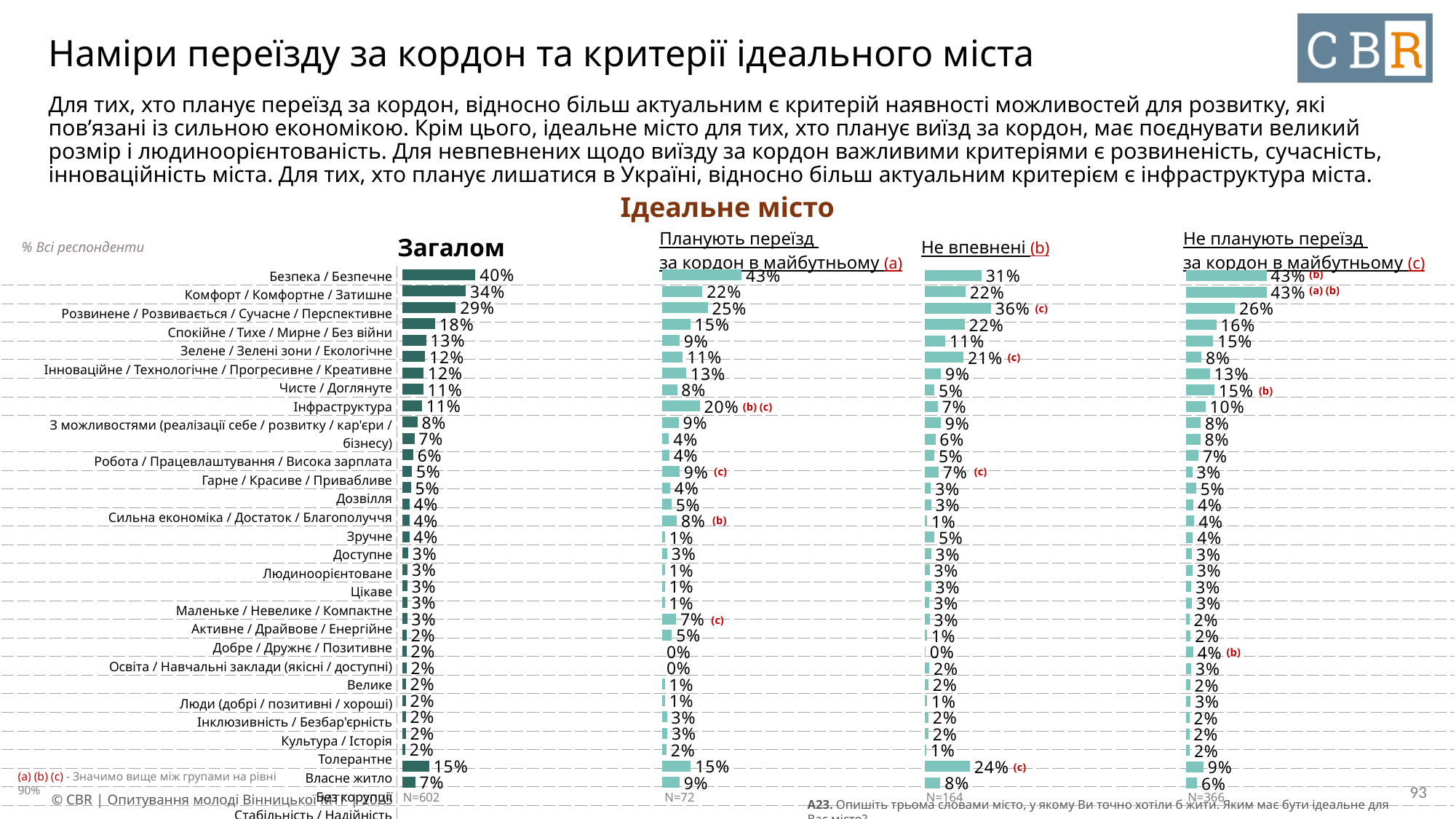
In the "Не впевнені (b)" chart, what is the value for "Комфорт / Комфортне / Затишне"? 22% What is the sample size (N) shown under the "Планують переїзд за кордон в майбутньому (a)" chart? N=72 In the "Загалом" chart, what is the value for "Безпека / Безпечне"? 40% In the "Загалом" chart, what is the value for "Спокійне / Тихе / Мирне / Без війни"? 18% In the "Загалом" chart, what is the difference between "Безпека / Безпечне" and "Комфорт / Комфортне / Затишне"? 6 percentage points What type of chart is used on this slide? Bar chart In the "Не планують переїзд за кордон в майбутньому (c)" chart, what is the value for "Розвинене / Розвивається / Сучасне / Перспективне"? 26% In the "Не впевнені (b)" chart, which category has the highest value? Розвинене / Розвивається / Сучасне / Перспективне In the "Планують переїзд за кордон в майбутньому (a)" chart, what is the value for "Безпека / Безпечне"? 43% How many bar charts are shown on the slide? 4 For "Безпека / Безпечне", which is larger: the value in the "Не впевнені (b)" chart or the value in the "Не планують переїзд за кордон в майбутньому (c)" chart? Не планують переїзд за кордон в майбутньому (c) In the "Загалом" chart, which category has the highest value? Безпека / Безпечне